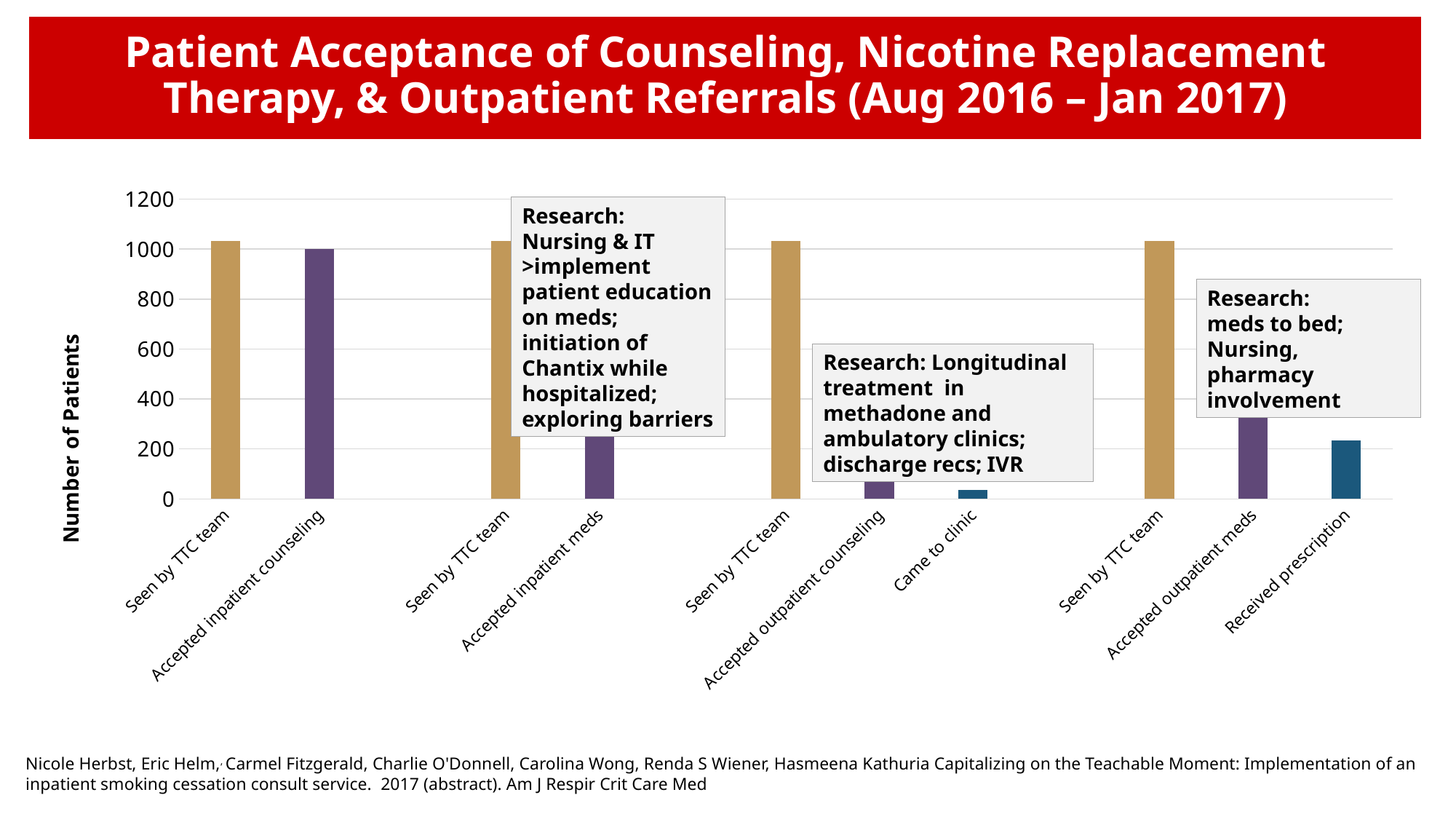
Which category has the lowest value in the chart? Came to clinic What kind of chart is shown on the slide? bar chart What is the label of the vertical axis? Number of Patients Which is larger, Accepted outpatient counseling or Came to clinic? Accepted outpatient counseling Which is larger, Received prescription or Came to clinic? Received prescription Is the value for Came to clinic greater or less than 200? less How many bars are plotted in the chart? 11 Is the value for Received prescription greater or less than 400? less Is the value for Seen by TTC team greater or less than 800? greater